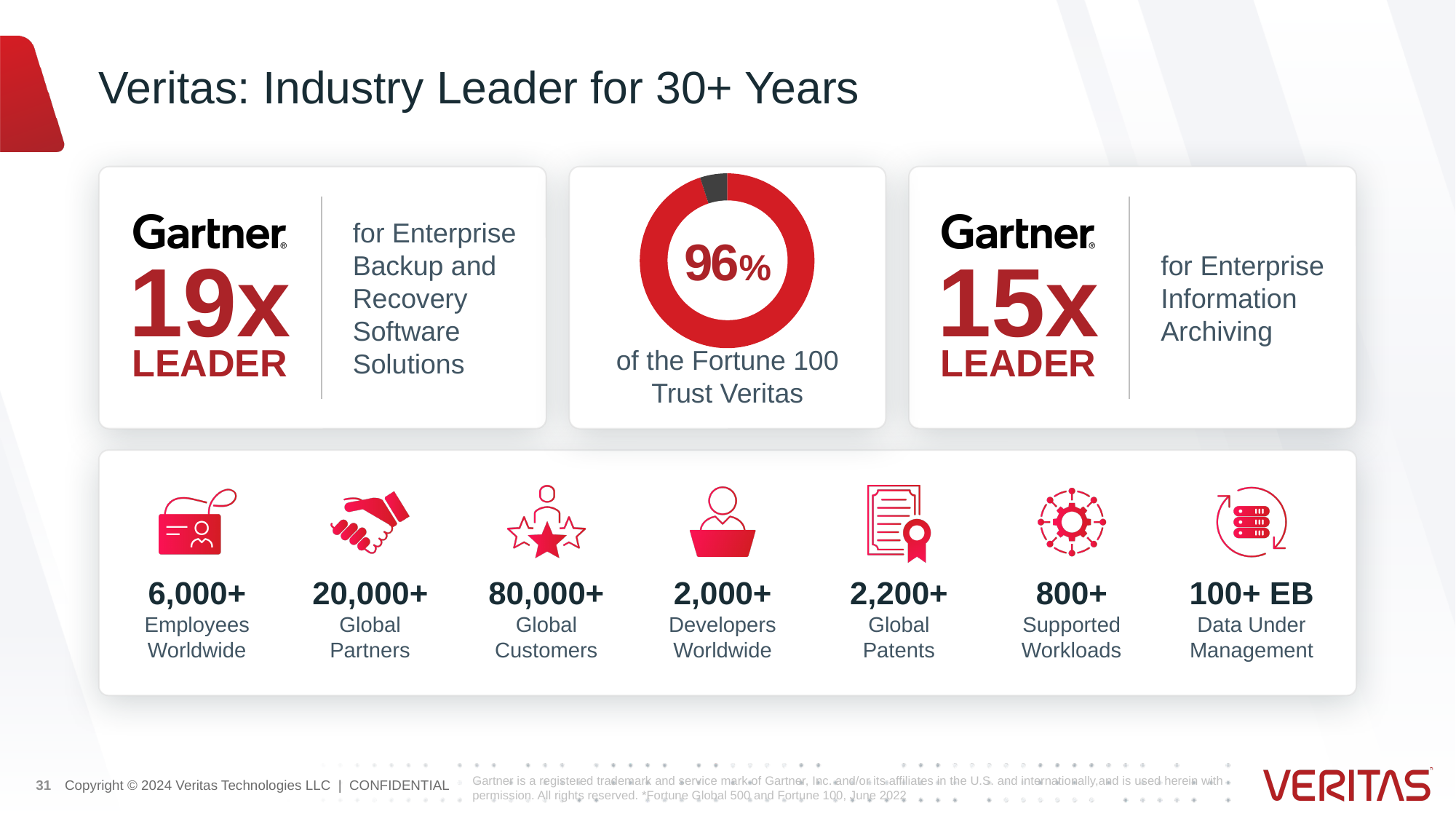
Is the value shown in the donut chart greater or less than 90%? greater According to the donut chart, what share of the Fortune 100 trust Veritas? 96% Which segment of the donut chart is larger, the red one or the dark grey one? the red one What percentage is shown in the centre of the donut chart? 96% What colour is the largest segment of the donut chart? red What share of the donut chart is not covered by the 96% red segment? 4% What kind of chart is shown in the middle card of the slide? donut chart What does the 96% in the donut chart represent? of the Fortune 100 Trust Veritas How many segments does the donut chart have? 2